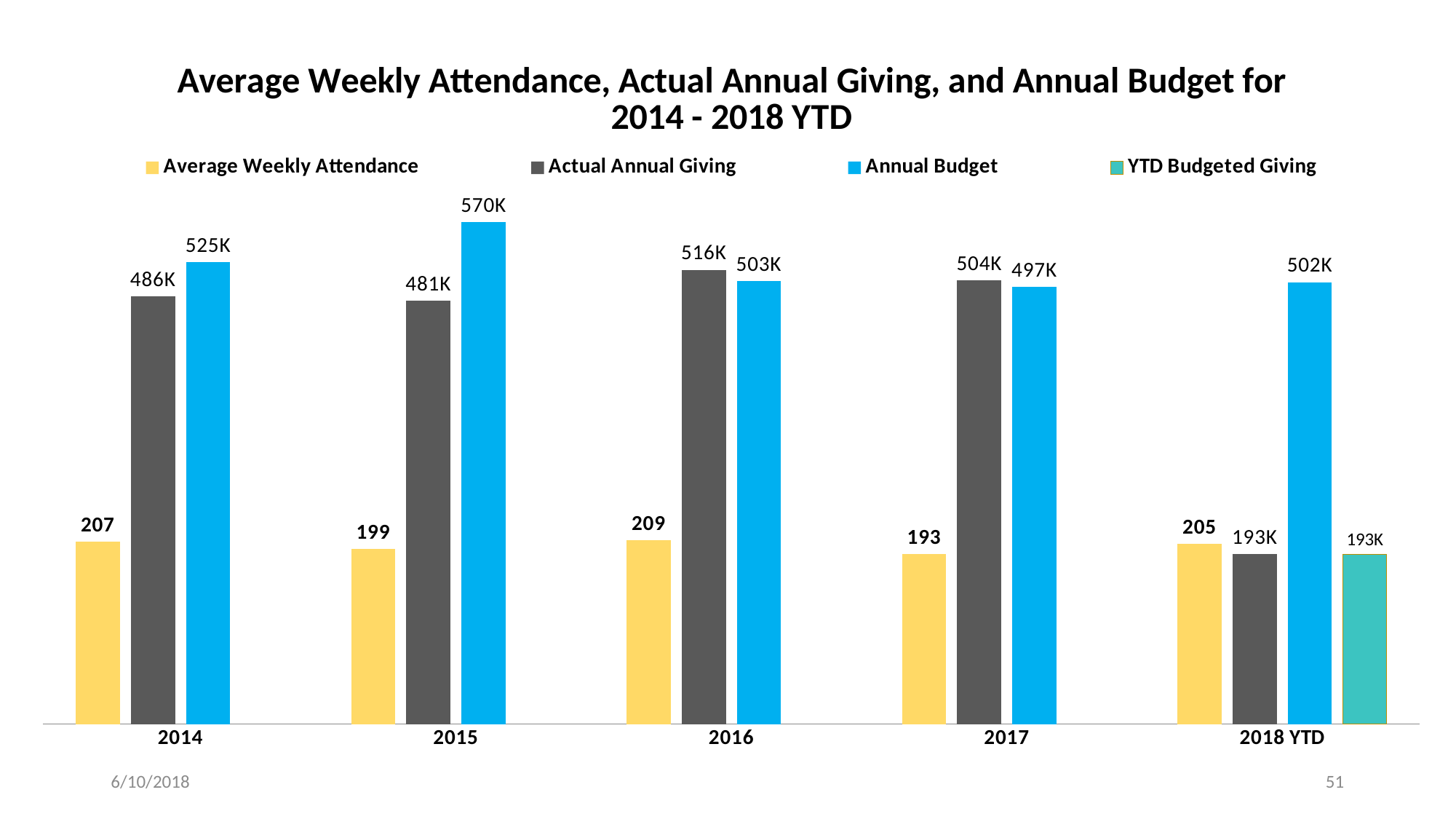
What kind of chart is shown on the slide? Bar chart What is the Actual Annual Giving for 2015? 481K How many year categories are shown on the x axis? 5 Which year has the lowest Average Weekly Attendance? 2017 Which year has the highest Annual Budget? 2015 Which colour represents Annual Budget in the legend? Blue How many series does the legend list? 4 Which is larger in 2016, Actual Annual Giving or Annual Budget? Actual Annual Giving What is the difference between the Annual Budget and the Actual Annual Giving in 2015? 89K What is the YTD Budgeted Giving for 2018 YTD? 193K What is the Average Weekly Attendance for 2016? 209 What is the Annual Budget for 2018 YTD? 502K